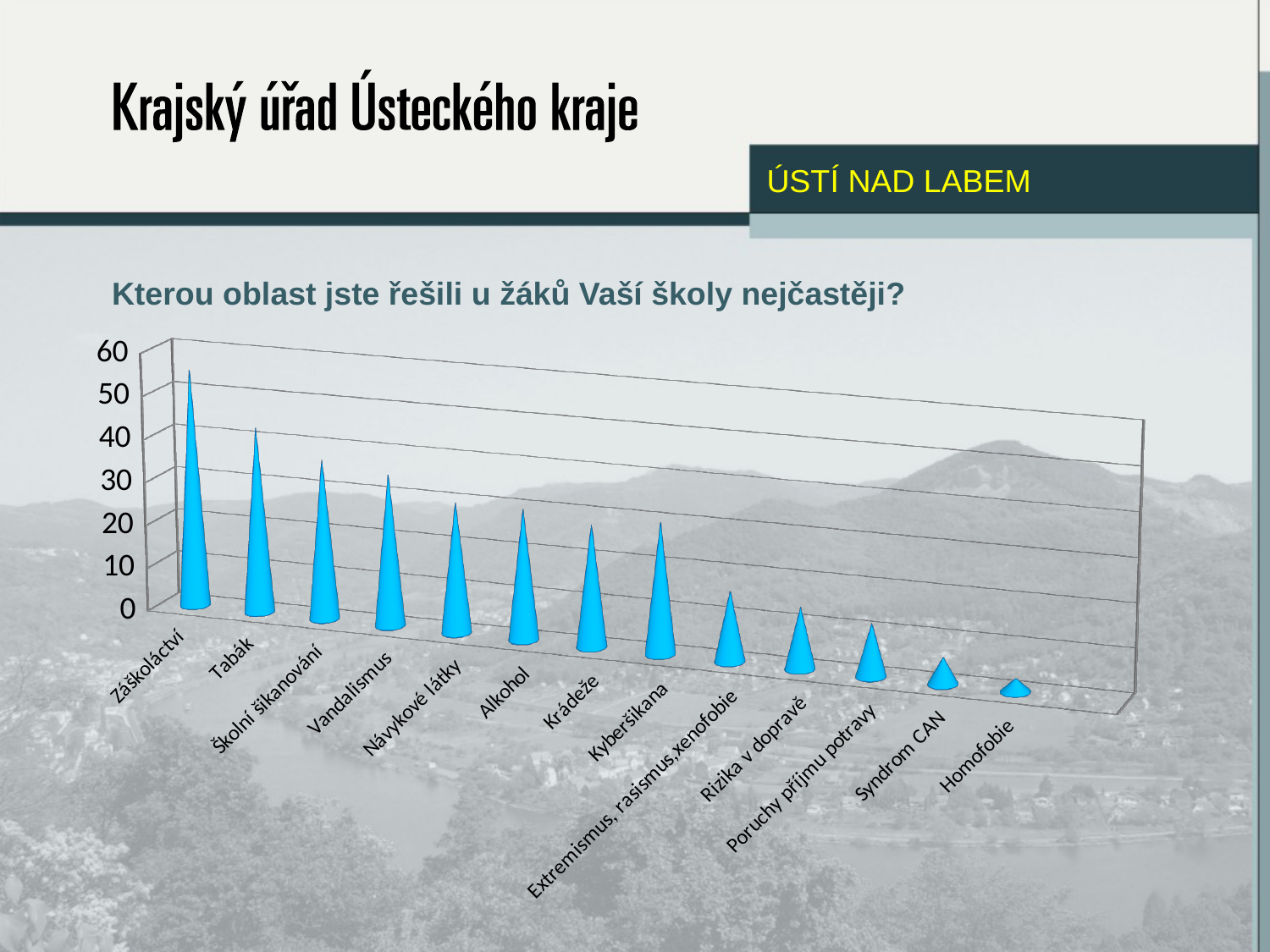
Is the value for Školní šikanování greater or less than 20? greater What is the title of the chart? Kterou oblast jste řešili u žáků Vaší školy nejčastěji? Which category has the highest value? Záškoláctví Is the value for Syndrom CAN greater or less than 10? less What kind of chart is shown on the slide? bar chart How many categories are plotted on the x axis? 13 Do the values rise or fall moving from left to right along the x axis? fall Is the value for Záškoláctví greater or less than 40? greater Which is larger, the value for Tabák or the value for Vandalismus? Tabák Which category has the lowest value? Homofobie